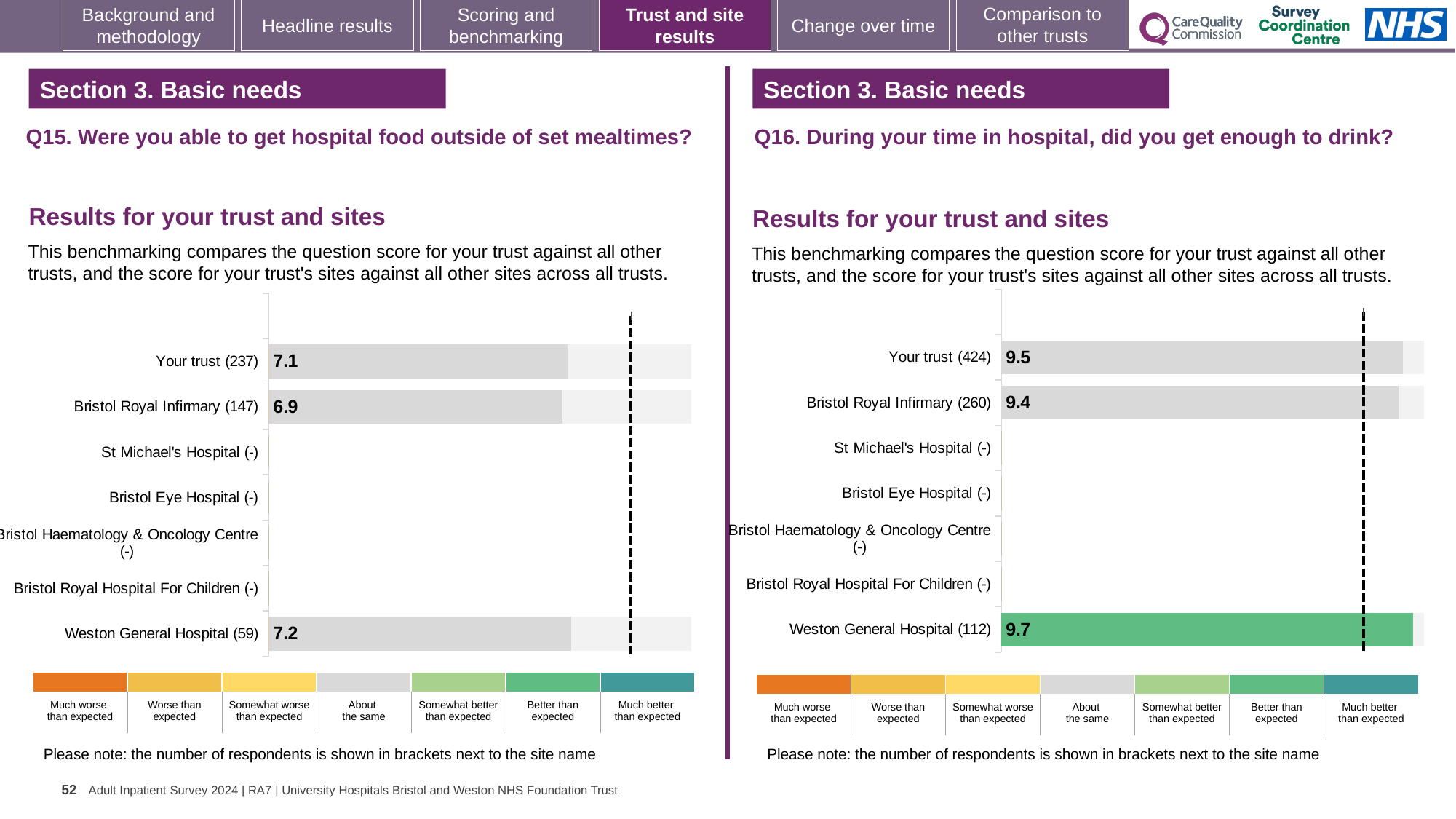
In the Q16 chart, which site with a plotted score has the highest value? Weston General Hospital In the Q15 chart, what is the difference between the Weston General Hospital score and the Bristol Royal Infirmary score? 0.3 What kind of chart is used for the Q16 results? Bar chart In the Q15 chart (hospital food outside of set mealtimes), what is the score for Your trust? 7.1 In the Q15 chart, which site with a plotted score has the lowest value? Bristol Royal Infirmary In the Q15 chart, what is the score for Weston General Hospital? 7.2 In the Q16 chart, is the score for Bristol Royal Infirmary or Your trust larger? Your trust In the Q16 chart, what is the score for Weston General Hospital? 9.7 In the Q16 chart, what is the difference between the Your trust score and the Bristol Royal Infirmary score? 0.1 How many site/trust categories are listed on the y axis of the Q15 chart? 7 In the Q16 chart (did you get enough to drink), what is the score for Your trust? 9.5 In the Q15 chart, what is the score for Bristol Royal Infirmary? 6.9